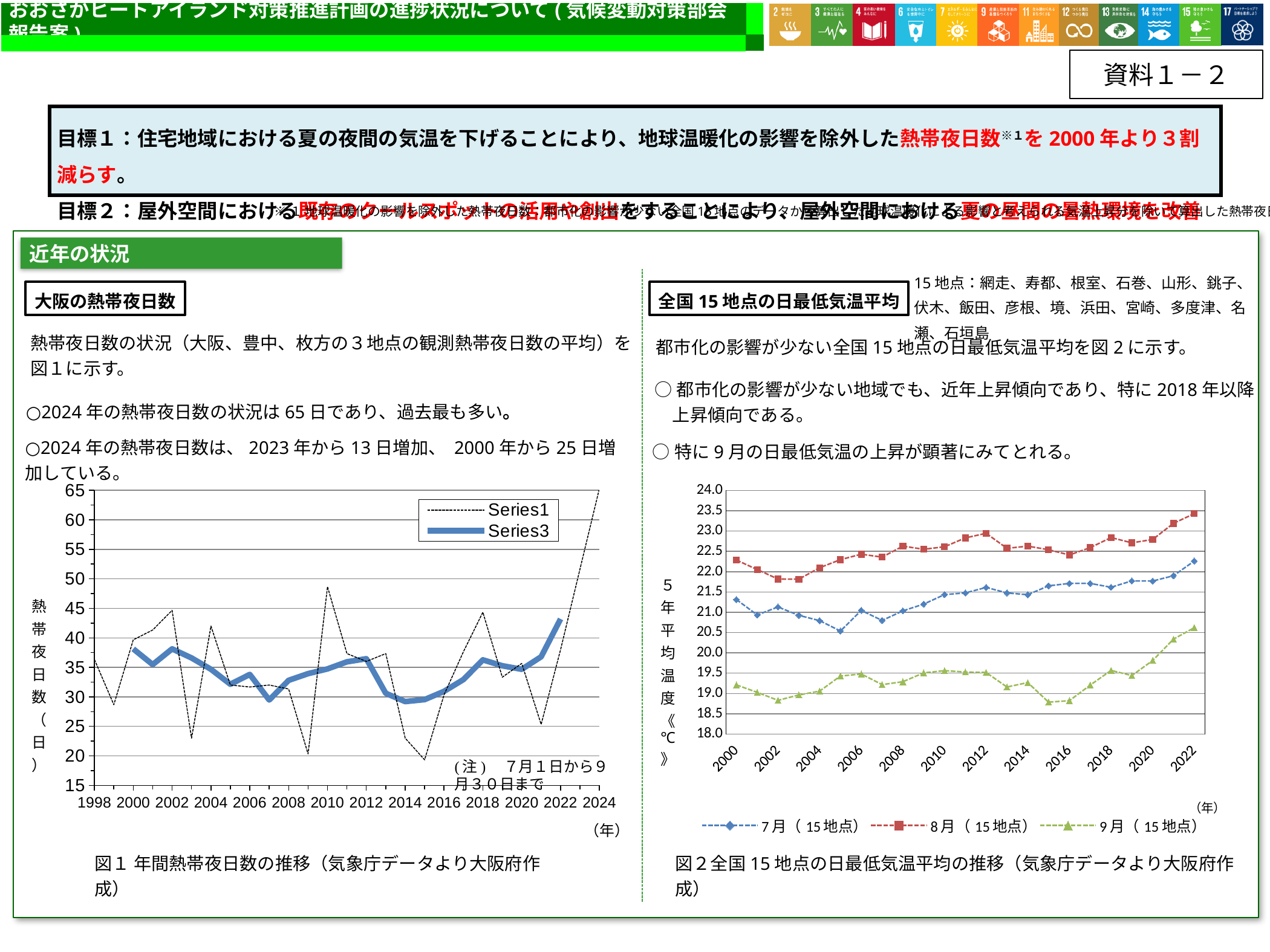
In 図1 年間熱帯夜日数の推移, what is the value of Series1 in 2024? 65 In 図1 年間熱帯夜日数の推移, is the value of Series1 in 2009 greater or less than 25? less In 図1 年間熱帯夜日数の推移, is the value of Series3 in 2022 greater or less than 40? greater How many series does the legend of 図2 全国15地点の日最低気温平均の推移 list? 3 In 図2 全国15地点の日最低気温平均の推移, is the value of 7月（15地点） in 2005 greater or less than 21.0? less How many series does the legend of 図1 年間熱帯夜日数の推移 list? 2 In 図1 年間熱帯夜日数の推移, in which year does Series1 reach its highest value? 2024 In 図2 全国15地点の日最低気温平均の推移, which series has the highest values across all years? 8月（15地点） In 図2 全国15地点の日最低気温平均の推移, which series has the lowest values across all years? 9月（15地点） What kind of chart is 図1 年間熱帯夜日数の推移 on the left of the slide? line chart In 図2 全国15地点の日最低気温平均の推移, does the 9月（15地点） series rise or fall from 2016 to 2022? rise